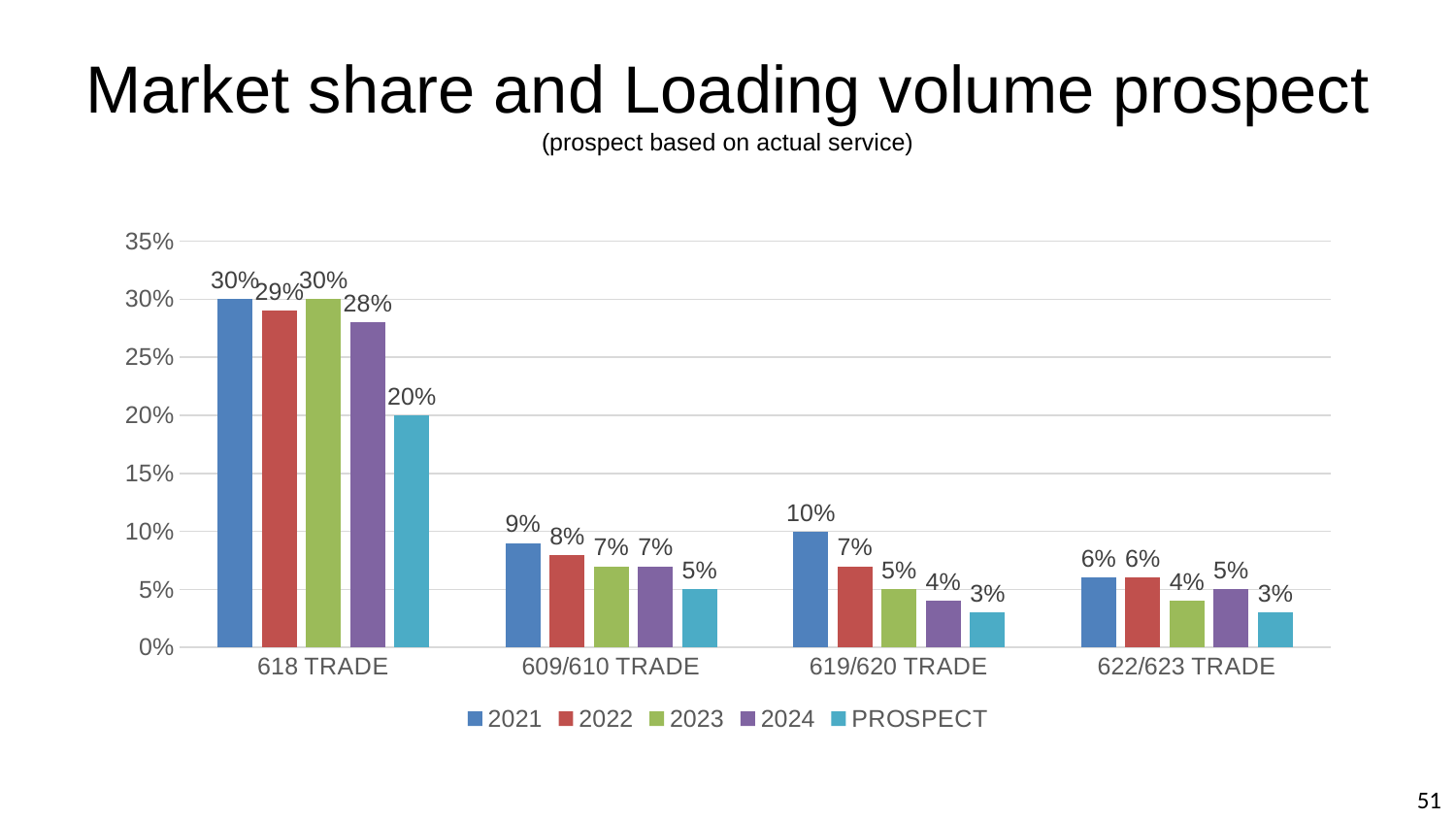
What is the 2021 value for 618 TRADE? 30% How many series does the legend list? 5 What is the difference between the 2024 and PROSPECT values for 618 TRADE? 8% Which trade has the highest 2021 value? 618 TRADE Do the values for 619/620 TRADE rise or fall from 2021 to PROSPECT? Fall What kind of chart is shown on the slide? Bar chart How many trade categories are shown on the x axis? 4 What is the 2023 value for 622/623 TRADE? 4% What is the PROSPECT value for 609/610 TRADE? 5% Which is larger for 619/620 TRADE, the 2021 value or the 2022 value? 2021 Which series has the lowest value for 618 TRADE? PROSPECT What is the 2024 value for 619/620 TRADE? 4%